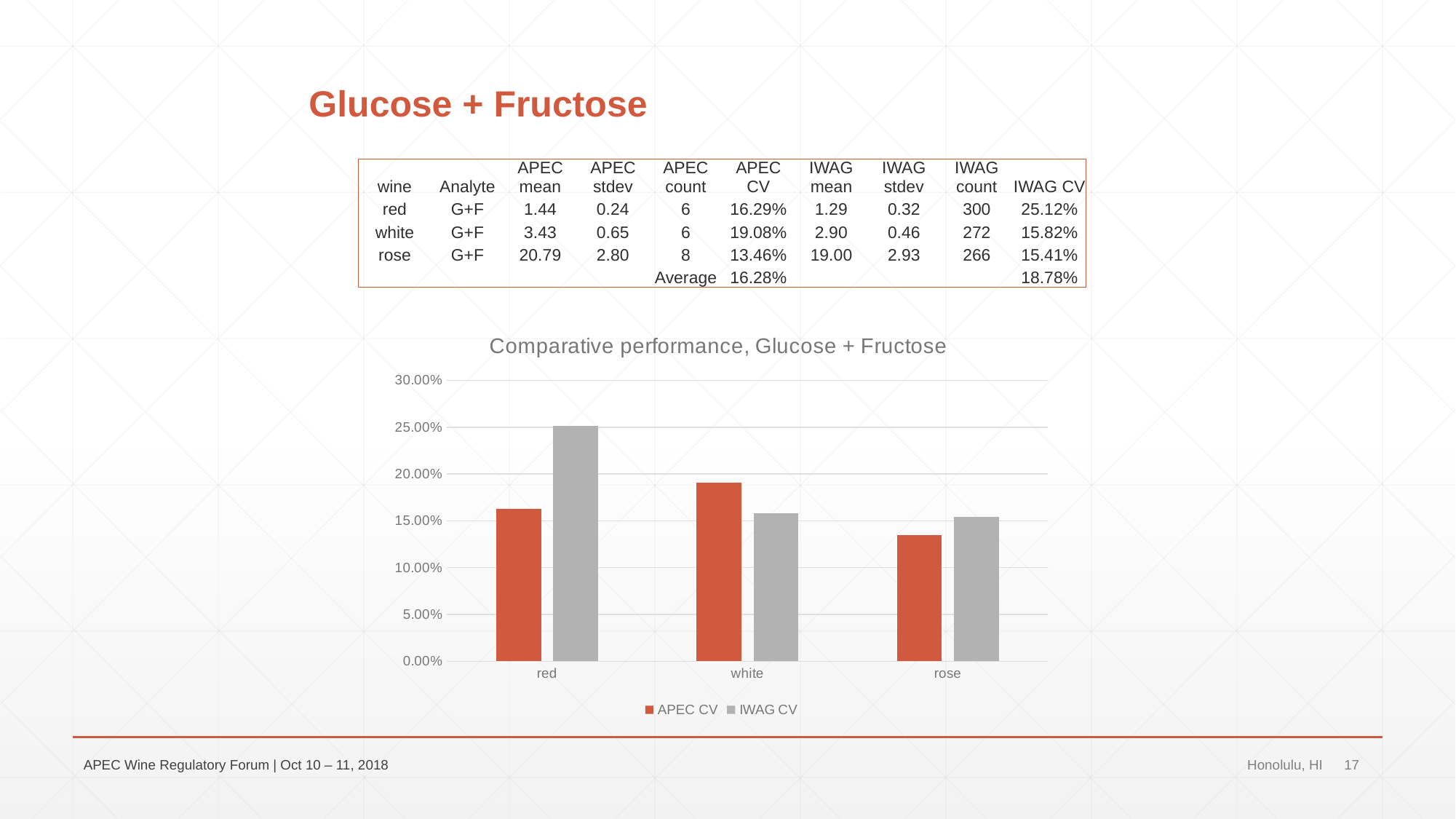
Is the APEC CV value for rose wine greater or less than 15.00%? less What type of chart is shown on the slide? bar chart Which wine has the highest IWAG CV bar in the chart? red Is the IWAG CV value for red wine greater or less than 20.00%? greater For red wine, which is larger in the chart: APEC CV or IWAG CV? IWAG CV According to the table on the slide, what is the APEC CV for white wine? 19.08% How many wine categories are shown on the x axis of the chart? 3 Which wine has the lowest APEC CV bar in the chart? rose Which series is drawn in grey in the chart? IWAG CV How many series does the chart legend list? 2 What is the title of the chart? Comparative performance, Glucose + Fructose For white wine, which is larger in the chart: APEC CV or IWAG CV? APEC CV